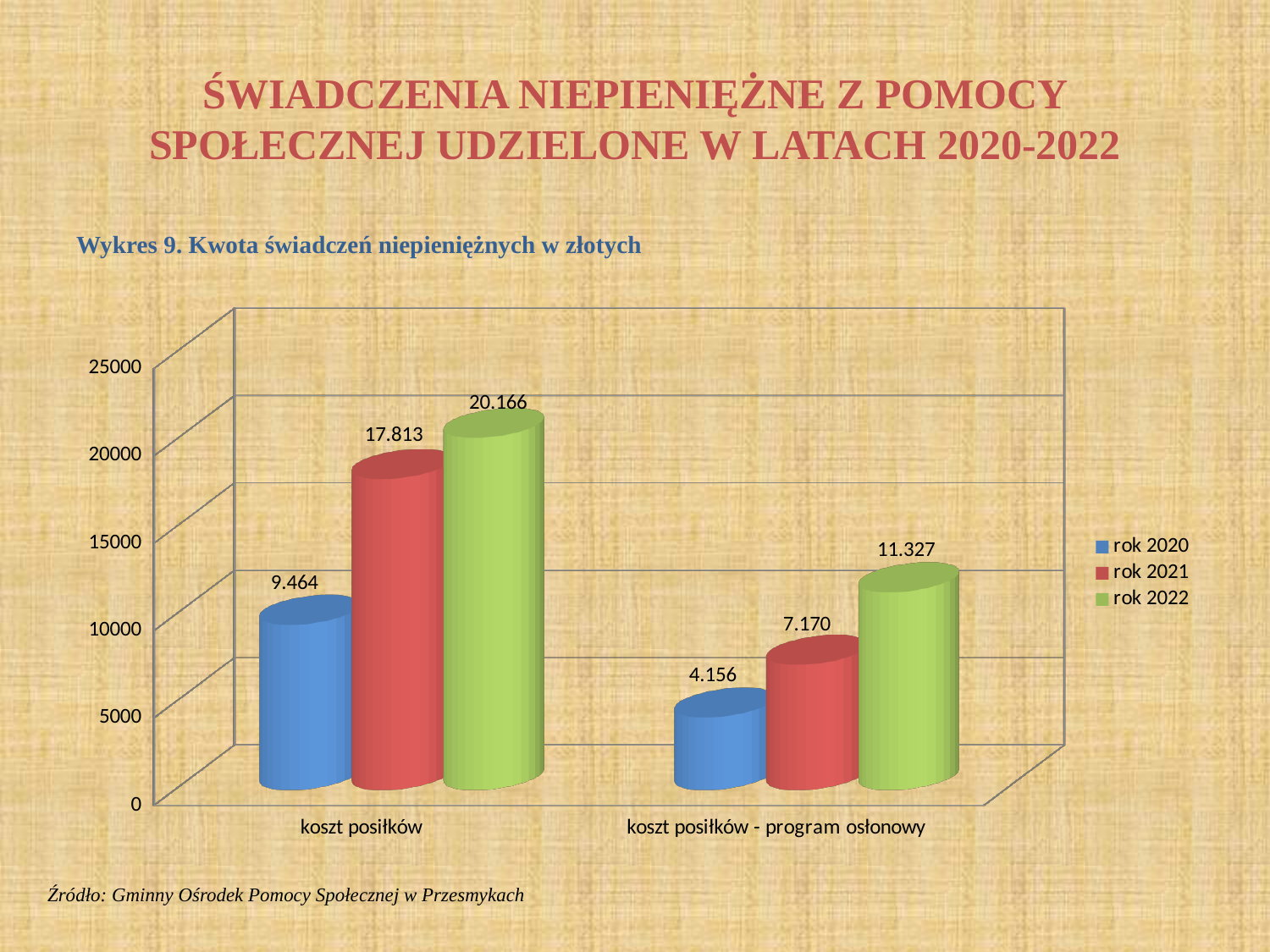
Which is larger: the rok 2020 value for koszt posiłków or the rok 2022 value for koszt posiłków - program osłonowy? rok 2022 value for koszt posiłków - program osłonowy How many categories are shown on the x axis? 2 How many series does the legend list? 3 Is the rok 2021 value for koszt posiłków - program osłonowy greater or less than 10000? less What is the difference between the rok 2022 and rok 2021 values in the koszt posiłków category? 2.353 Which series has the highest value in the koszt posiłków - program osłonowy category? rok 2022 Which series has the lowest value in the koszt posiłków category? rok 2020 What is the value for rok 2021 in the koszt posiłków category? 17.813 What is the value for rok 2022 in the koszt posiłków category? 20.166 What kind of chart is shown on the slide? bar chart What is the difference between the rok 2021 and rok 2020 values in the koszt posiłków - program osłonowy category? 3.014 What is the value for rok 2020 in the koszt posiłków - program osłonowy category? 4.156